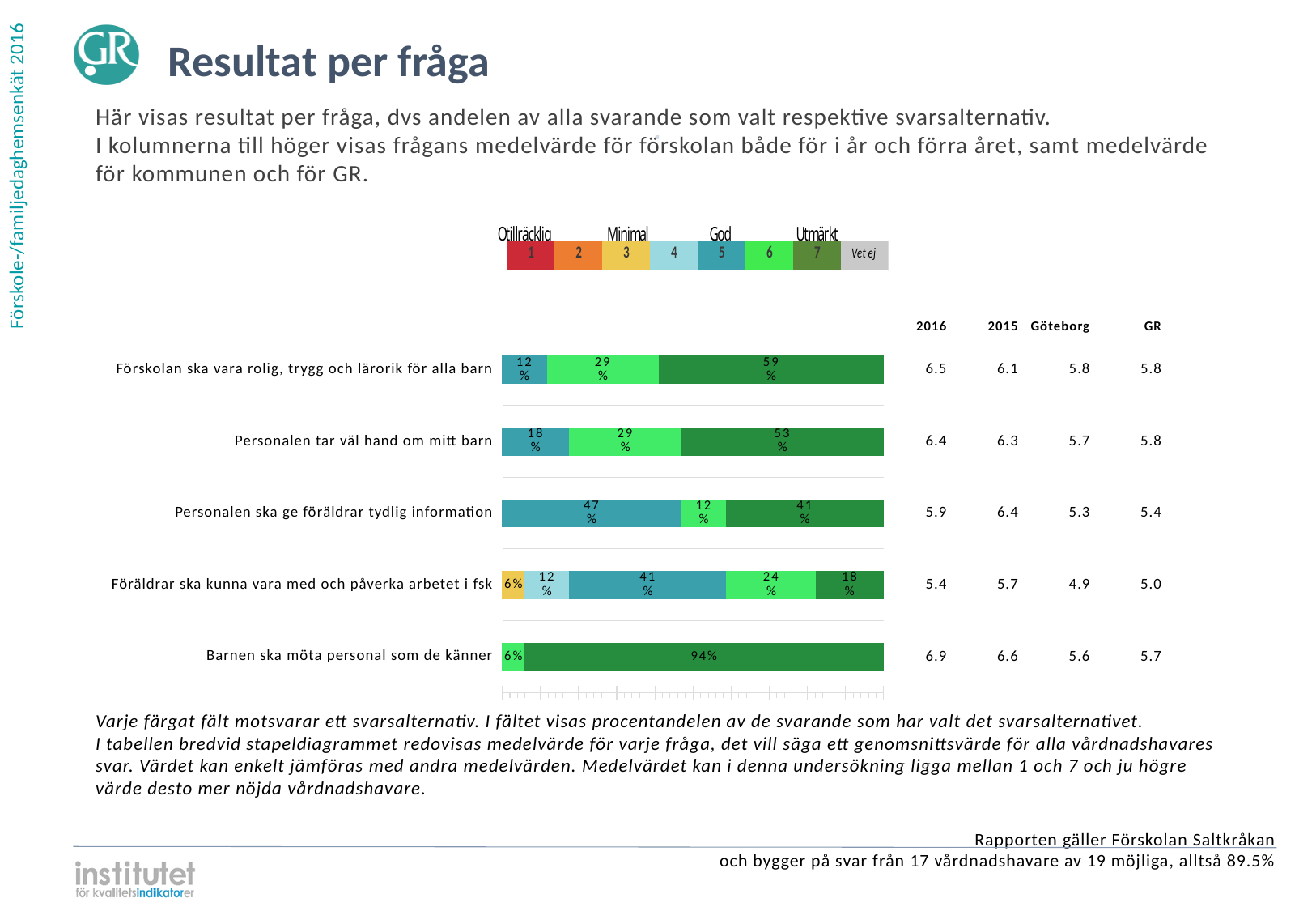
What is the difference between the answer 7 share for "Förskolan ska vara rolig, trygg och lärorik för alla barn" (59%) and for "Personalen tar väl hand om mitt barn" (53%)? 6% What percentage of respondents chose answer 7 (dark green) for "Barnen ska möta personal som de känner"? 94% Which is larger: the answer 5 (teal) share for "Personalen tar väl hand om mitt barn" or for "Personalen ska ge föräldrar tydlig information"? Personalen ska ge föräldrar tydlig information Which question has the smallest share of respondents choosing answer 7 (dark green)? Föräldrar ska kunna vara med och påverka arbetet i fsk How many answer alternatives does the colour legend above the chart list, including "Vet ej"? 8 What percentage of respondents chose answer 7 (dark green) for "Förskolan ska vara rolig, trygg och lärorik för alla barn"? 59% How many questions (categories) are plotted in the bar chart? 5 What is the 2016 mean value shown for "Barnen ska möta personal som de känner"? 6.9 What kind of chart is shown on the slide? stacked bar chart What percentage of respondents chose answer 5 (teal) for "Personalen ska ge föräldrar tydlig information"? 47% What is the combined share of answers 6 and 7 for "Föräldrar ska kunna vara med och påverka arbetet i fsk" (24% + 18%)? 42% Which question has the largest share of respondents choosing answer 7 (dark green)? Barnen ska möta personal som de känner